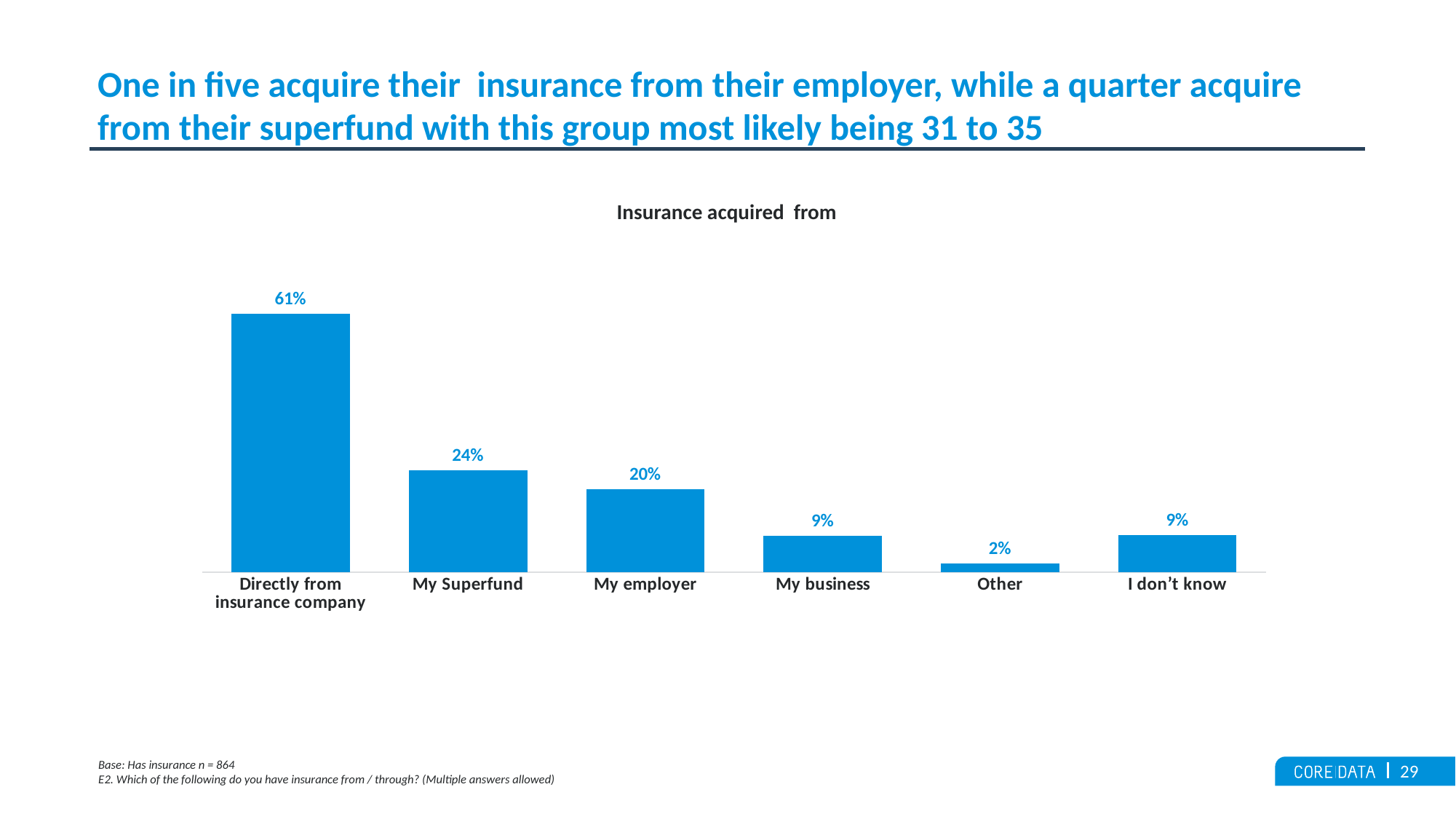
What is the value for My employer? 20% What percentage acquired their insurance directly from an insurance company? 61% What type of chart is shown? Bar chart What is the value for Other? 2% What is the difference between My employer and My business? 11% Which category has the lowest value? Other What is the value for My Superfund? 24% What is the difference between Directly from insurance company and My Superfund? 37% Which is larger, My Superfund or My employer? My Superfund How many categories are shown in the chart? 6 Which category has the highest value? Directly from insurance company What is the title of the chart? Insurance acquired from